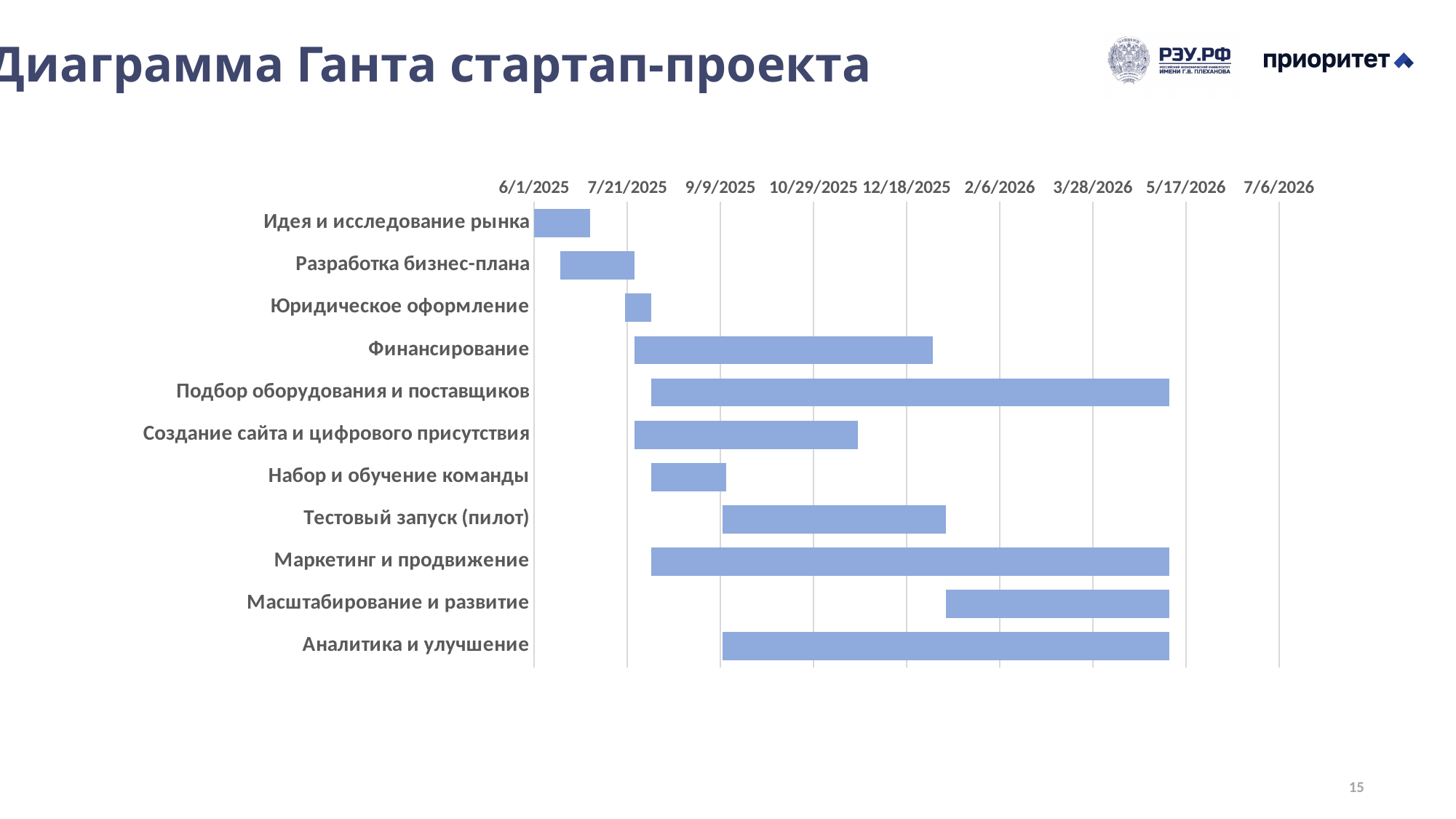
What is the first date shown on the horizontal axis of the chart? 6/1/2025 What is the title of the slide with the Gantt chart? Диаграмма Ганта стартап-проекта Which task has the shortest bar in the chart? Юридическое оформление Does the bar for "Набор и обучение команды" start before or after 9/9/2025? before Which task starts earliest in the chart? Идея и исследование рынка Does the bar for "Масштабирование и развитие" start before or after 2/6/2026? before Which bar is longer, "Финансирование" or "Юридическое оформление"? Финансирование Which task starts earlier, "Разработка бизнес-плана" or "Юридическое оформление"? Разработка бизнес-плана What kind of chart is shown on the slide? Bar chart (Gantt chart) Does the bar for "Создание сайта и цифрового присутствия" end before or after 12/18/2025? before Which task starts latest in the chart? Масштабирование и развитие How many tasks (categories) are listed on the vertical axis of the chart? 11